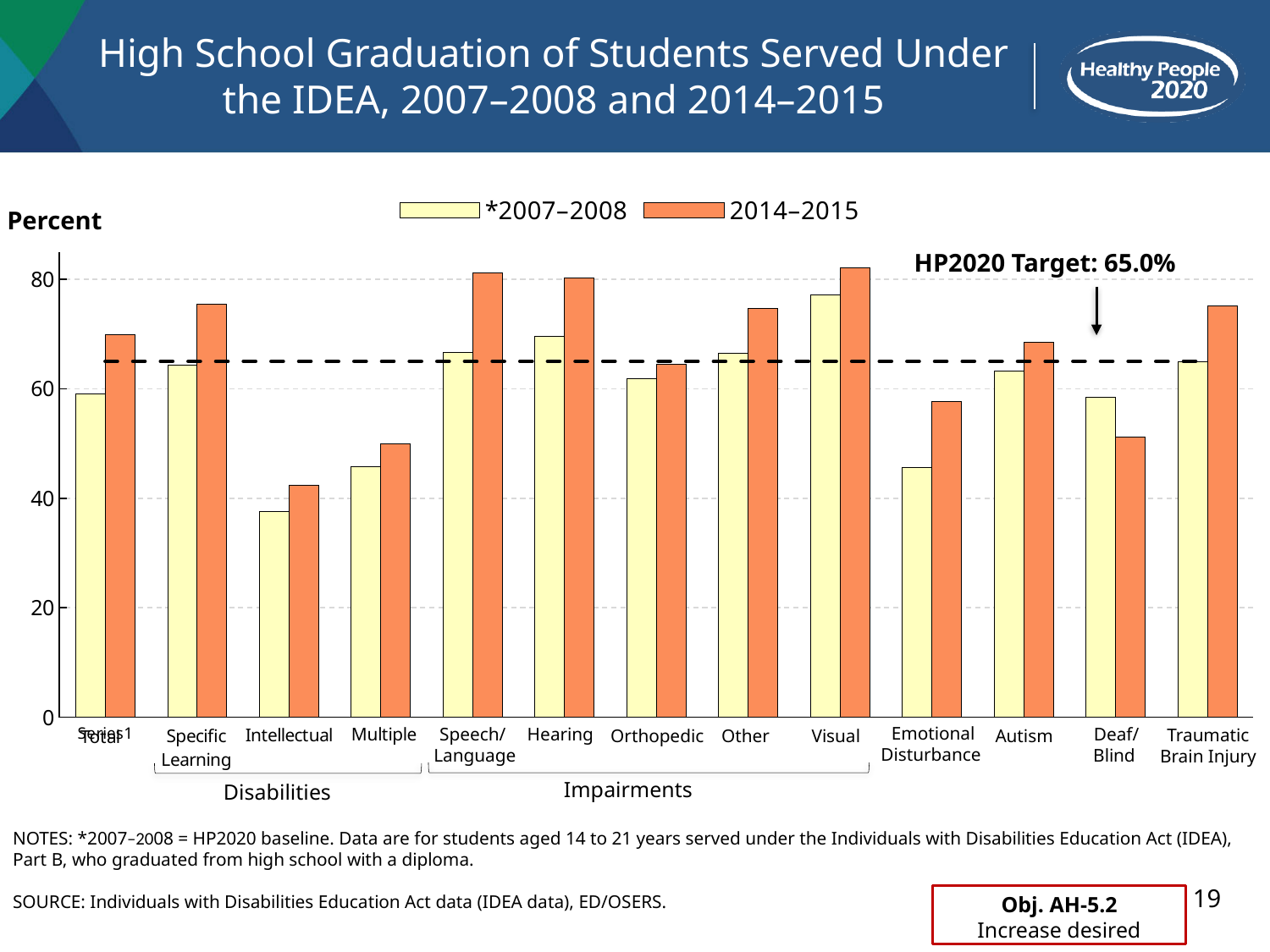
Is the 2014–2015 value for Speech/Language greater or less than 60? greater For Deaf/Blind, which is larger: the *2007–2008 value or the 2014–2015 value? *2007–2008 Which category has the lowest *2007–2008 value? Intellectual Is the *2007–2008 value for Emotional Disturbance greater or less than 60? less For Total, which is larger: the *2007–2008 value or the 2014–2015 value? 2014–2015 How many categories are shown along the x axis? 13 Which category has the highest *2007–2008 value? Visual Is the 2014–2015 value for Intellectual greater or less than 60? less What kind of chart is shown on the slide? bar chart What is the HP2020 Target shown on the chart? 65.0% Which category has the lowest 2014–2015 value? Intellectual How many series does the legend list? 2